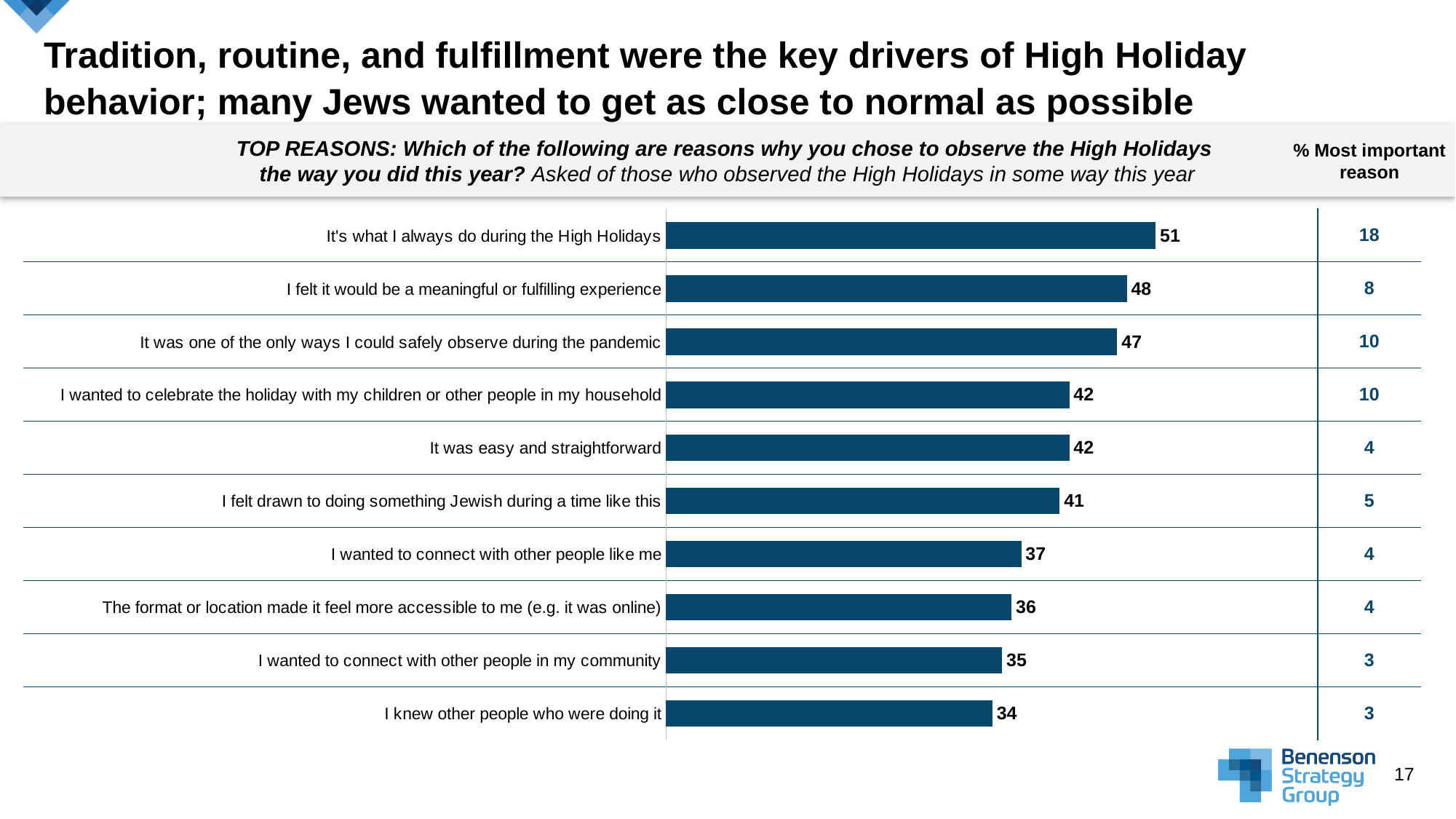
Which reason has the lowest value in the bar chart? I knew other people who were doing it What value is shown for "It's what I always do during the High Holidays"? 51 What value is shown for "It was one of the only ways I could safely observe during the pandemic"? 47 What is the difference between the bar values for "I felt drawn to doing something Jewish during a time like this" and "I knew other people who were doing it"? 7 What is the "% Most important reason" value for "It's what I always do during the High Holidays"? 18 What is the "% Most important reason" value for "It was easy and straightforward"? 4 How many reasons are plotted in the bar chart? 10 Which reason has the highest value in the bar chart? It's what I always do during the High Holidays What is the difference between the values for "It's what I always do during the High Holidays" and "I felt it would be a meaningful or fulfilling experience"? 3 What kind of chart is shown on the slide? Bar chart What value is shown for "I knew other people who were doing it"? 34 Which is larger: the value for "I wanted to connect with other people like me" or "I wanted to connect with other people in my community"? I wanted to connect with other people like me